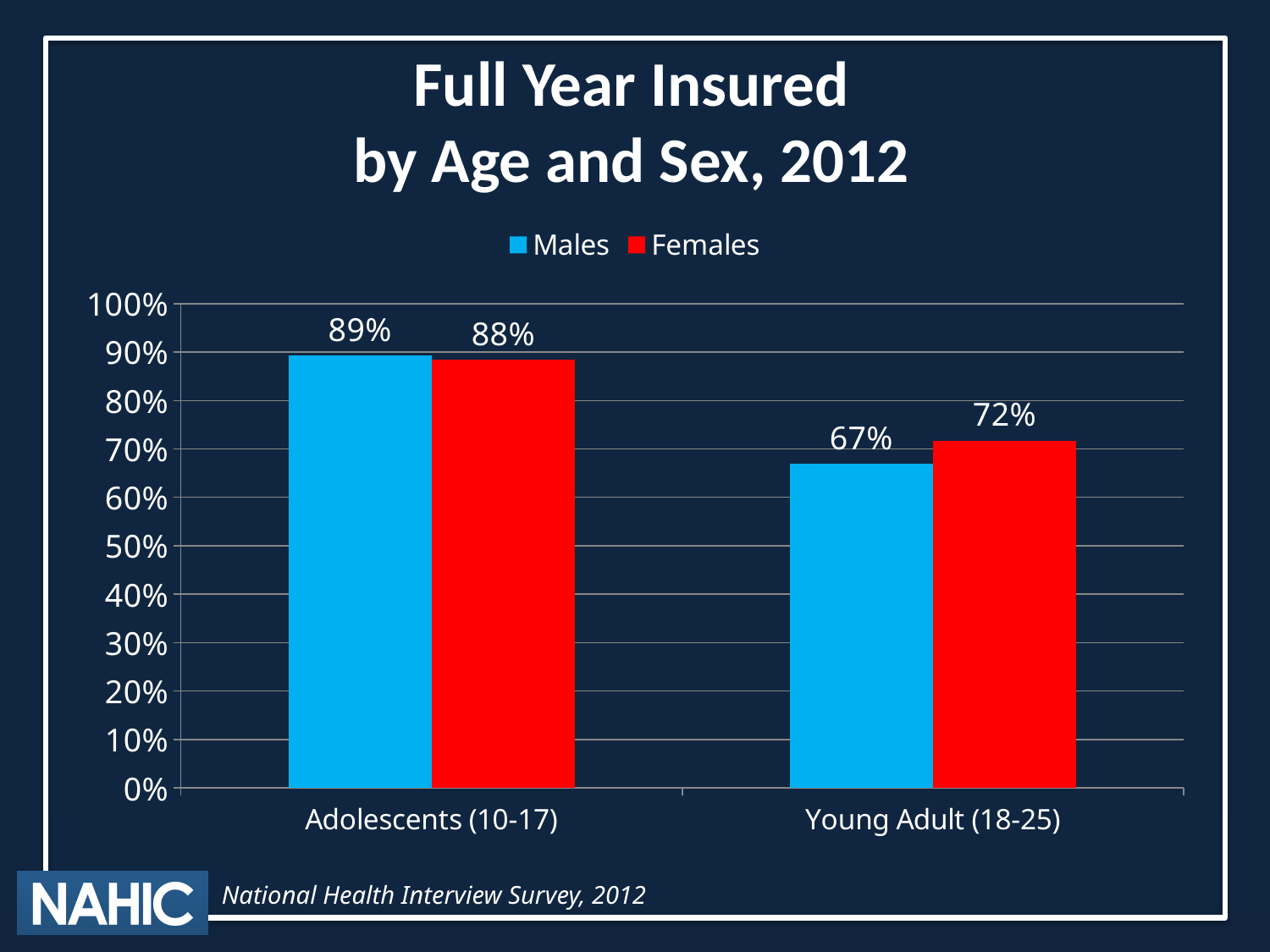
Which group and sex has the lowest full-year insured percentage? Young Adult (18-25) Males What percentage of young adult (18-25) males were insured for the full year? 67% How many series does the legend list? 2 What type of chart is shown on the slide? Bar chart How many age groups are shown on the x axis? 2 What percentage of adolescent (10-17) females were insured for the full year? 88% Which group and sex has the highest full-year insured percentage? Adolescents (10-17) Males What percentage of adolescent (10-17) males were insured for the full year? 89% What is the difference between the adolescent (10-17) male and young adult (18-25) male full-year insured percentages? 22% What is the difference between the male and female full-year insured percentages for young adults (18-25)? 5% Among young adults (18-25), which sex has the higher full-year insured percentage? Females What percentage of young adult (18-25) females were insured for the full year? 72%